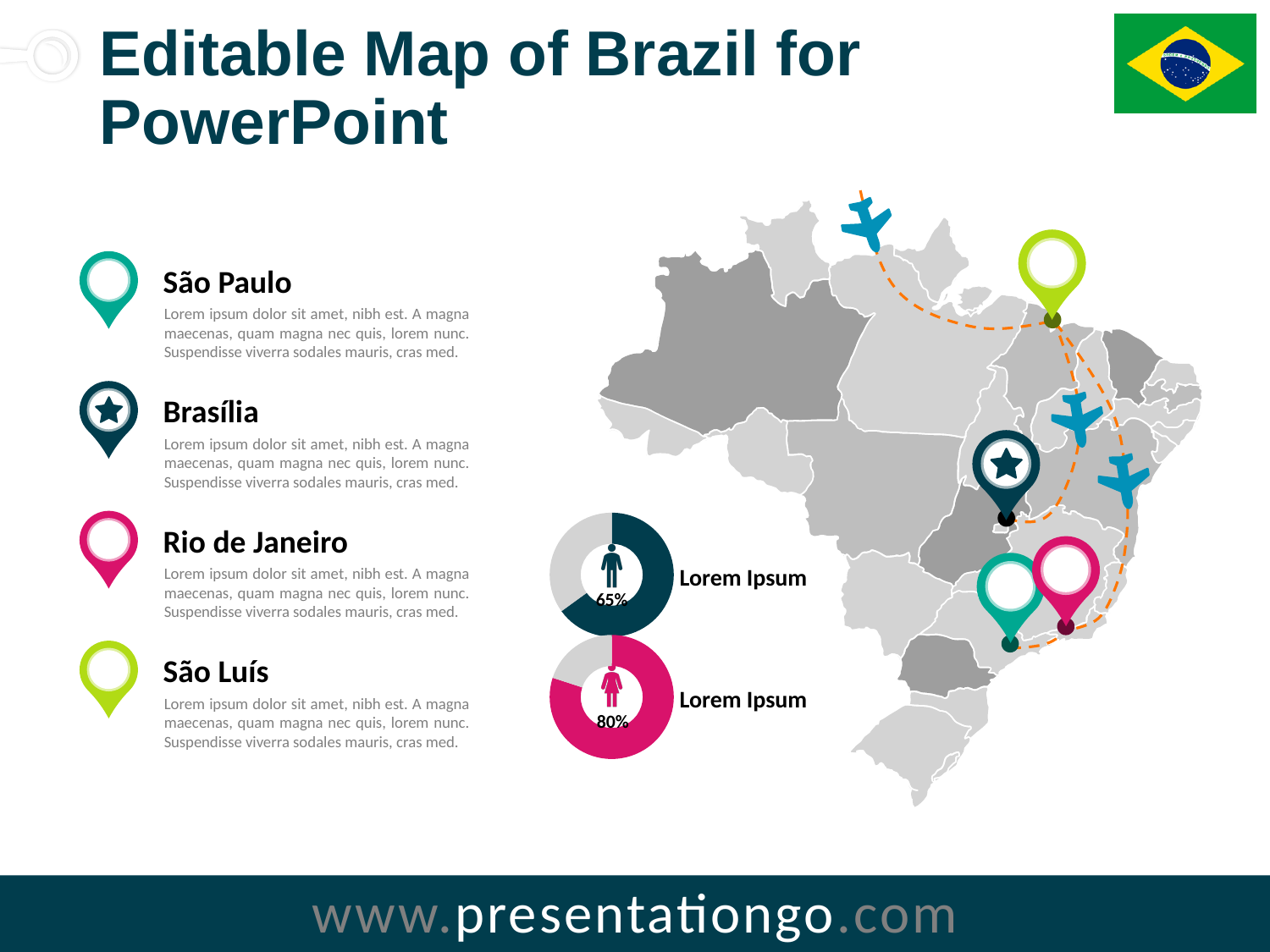
What value is shown on the lower donut chart with the female figure icon? 80% What is the difference between the value on the lower donut chart (80%) and the value on the upper donut chart (65%)? 15% How many donut charts are shown on the slide? 2 What kind of chart is the upper chart with the male figure icon? donut chart What colour is the filled portion of the lower donut chart showing 80%? pink Which donut chart shows the smaller value, the upper one (male icon) or the lower one (female icon)? the upper one (male icon) Which donut chart shows the larger value, the upper one (male icon) or the lower one (female icon)? the lower one (female icon) Is the value on the upper donut chart (male icon) greater or less than 50%? greater What value is shown on the upper donut chart with the male figure icon? 65% What label appears next to the upper donut chart? Lorem Ipsum